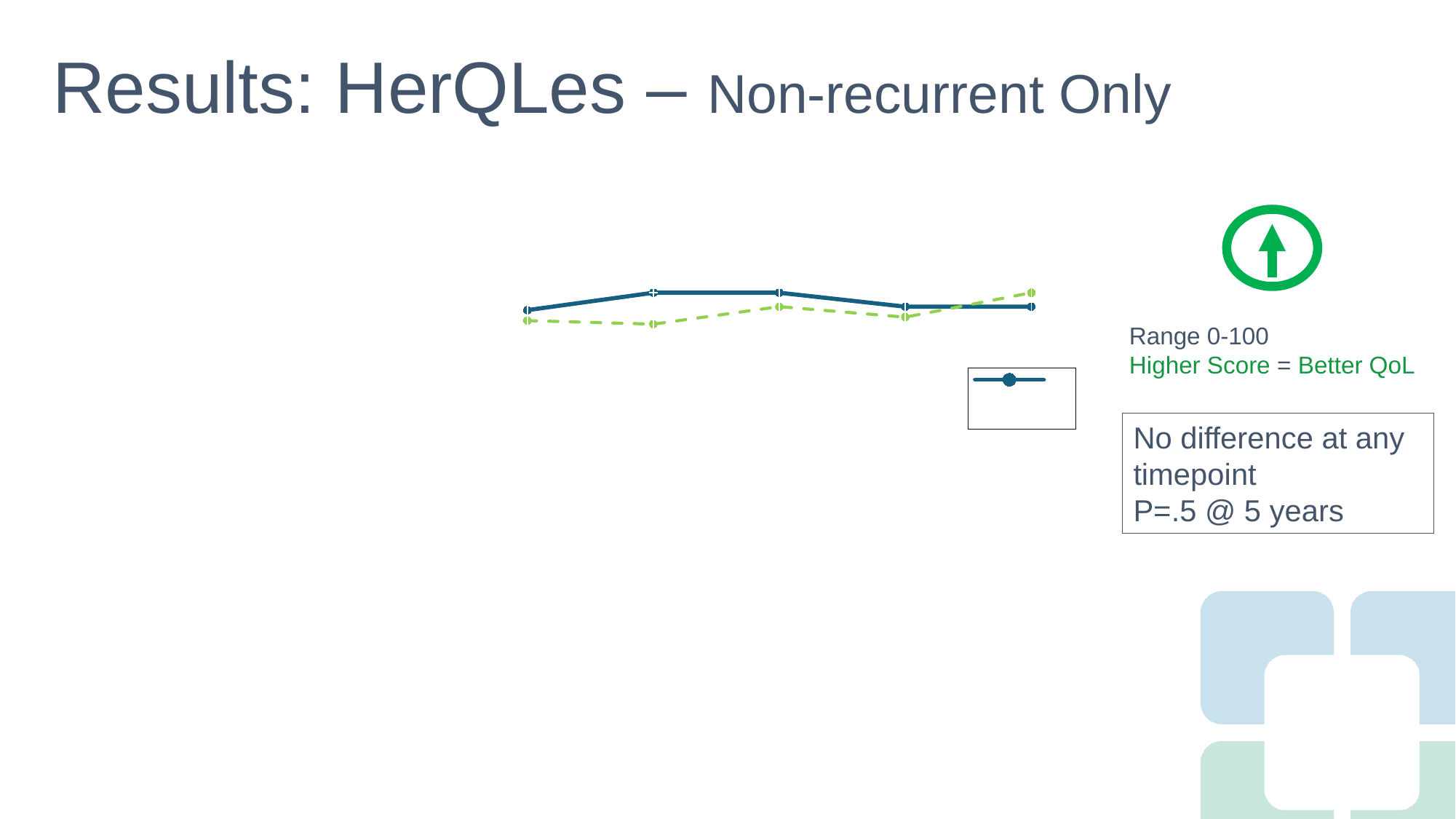
Which point on the dashed green line is the highest? the last (fifth) point What line style is used for the green series? dashed What kind of chart is shown on the slide? line chart How many data points does the solid blue line have? 5 What colour is the solid line on the chart? blue How many lines are plotted on the chart? 2 At the first (leftmost) point, which line is higher, the solid blue line or the dashed green line? solid blue line Which point on the dashed green line is the lowest? the second point At the second point from the left, which line is higher, the solid blue line or the dashed green line? solid blue line How many data points does the dashed green line have? 5 Does the dashed green line end higher or lower than it starts? higher At the last (rightmost) point, which line is higher, the solid blue line or the dashed green line? dashed green line